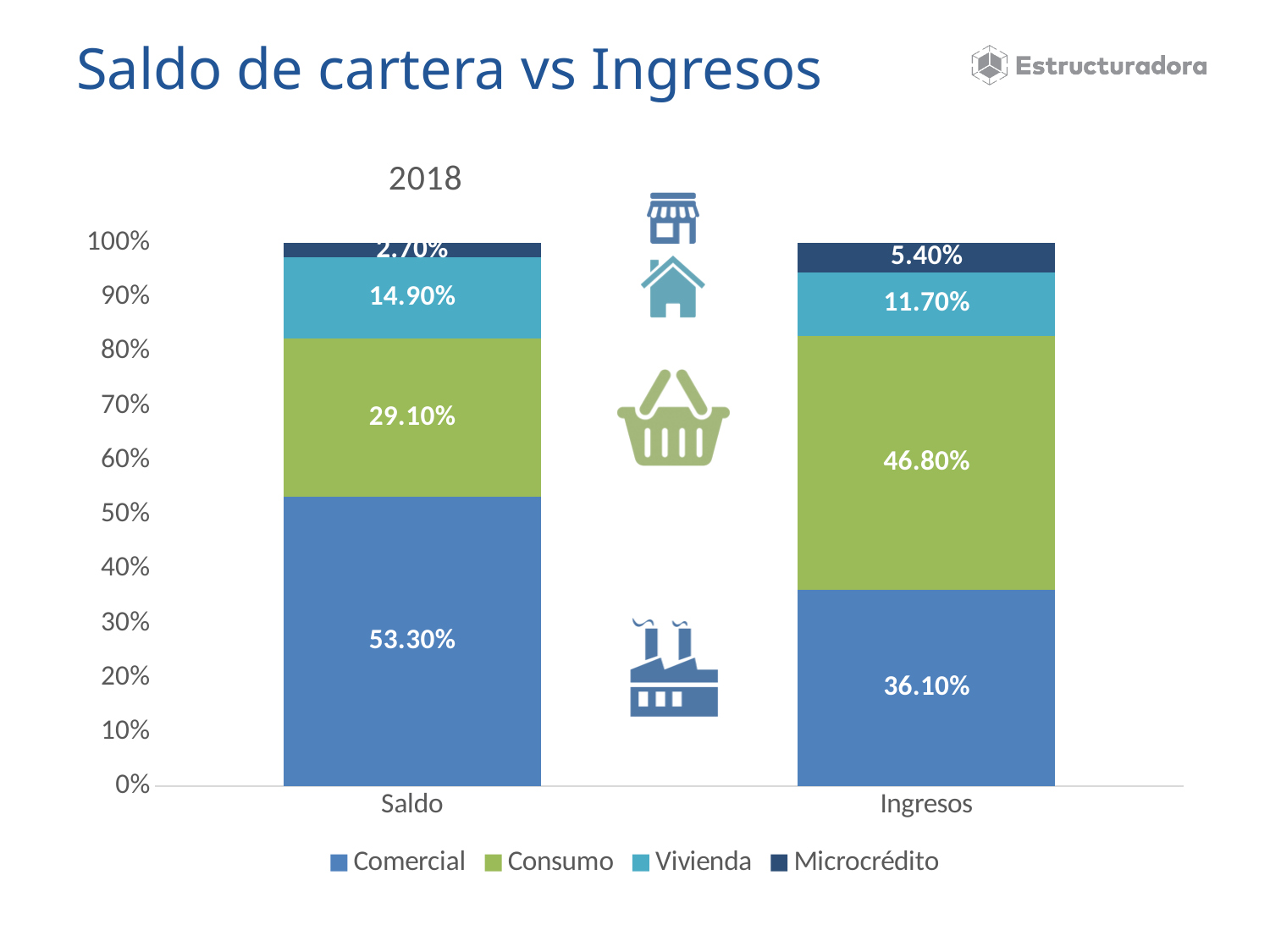
What year label appears above the chart? 2018 What is the Comercial share of the Saldo bar? 53.30% How many bars (categories) are plotted on the x axis? 2 Which series is the largest segment of the Ingresos bar? Consumo What is the Vivienda share of the Saldo bar? 14.90% Which bar has the larger Comercial share, Saldo or Ingresos? Saldo What is the difference between the Vivienda share in Saldo and the Vivienda share in Ingresos? 3.20% What is the Consumo share of the Ingresos bar? 46.80% What kind of chart is shown on the slide? Stacked bar chart What is the difference between the Consumo share in Ingresos and the Consumo share in Saldo? 17.70% What is the Microcrédito share of the Ingresos bar? 5.40% How many series does the legend list? 4